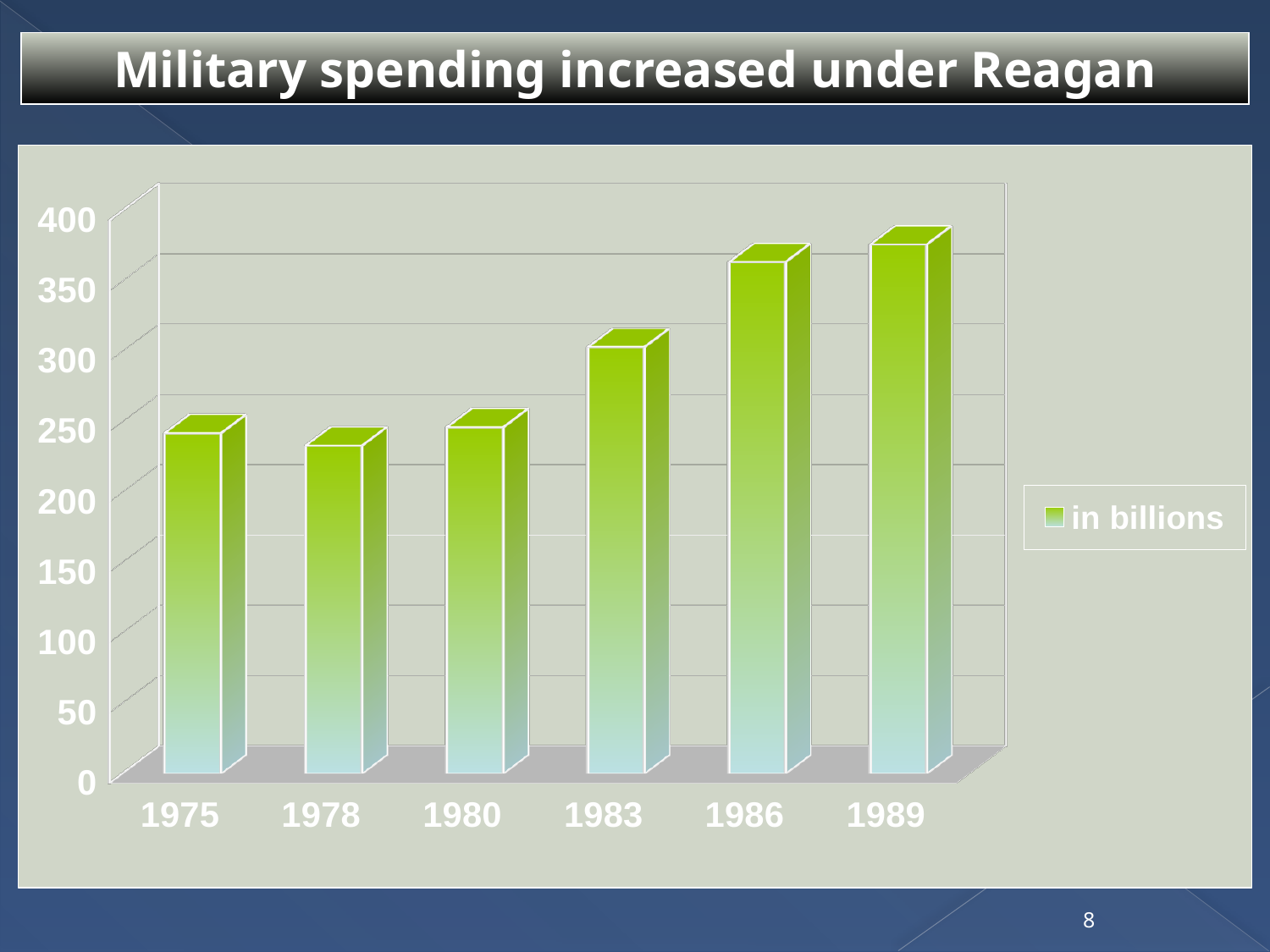
What is the legend entry for the series in the chart? in billions Is the value for 1986 greater or less than 350? greater What is the title of the slide containing the chart? Military spending increased under Reagan Do the values generally rise or fall from 1975 to 1989? rise Is the value for 1978 greater or less than 250? less Which is larger, the value for 1986 or the value for 1983? 1986 How many series does the chart's legend list? 1 Is the value for 1975 greater or less than 200? greater Which year has the highest bar in the chart? 1989 How many years are shown on the x axis of the chart? 6 Which year has the lowest bar in the chart? 1978 What kind of chart is shown on the slide? bar chart